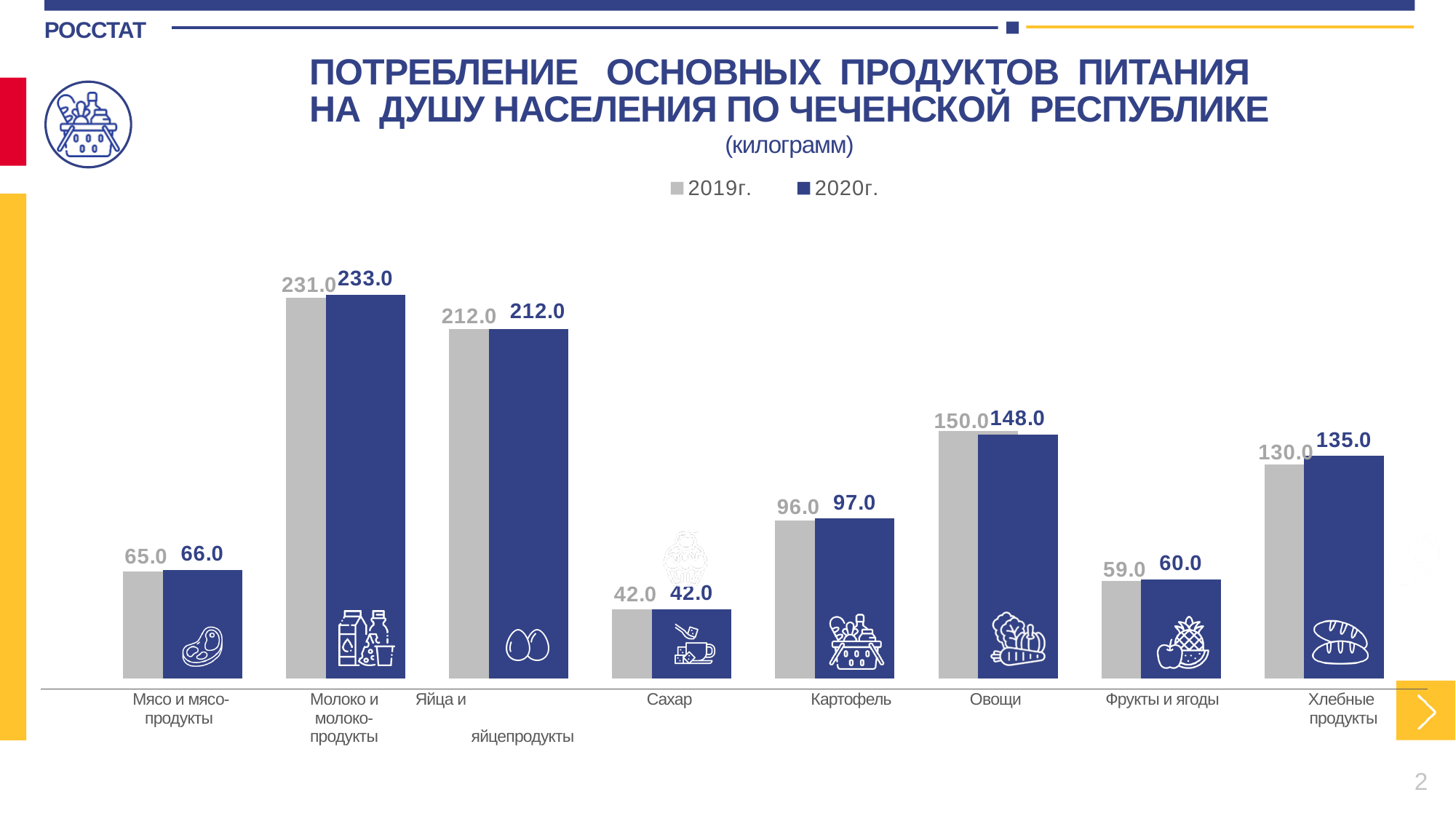
What is the 2020г. value for Картофель? 97.0 How many series does the legend list? 2 What is the difference between the 2019г. and 2020г. values for Овощи? 2.0 What unit of measurement is given under the chart title? килограмм How many product categories are shown on the chart? 8 Which category has the lowest 2019г. value? Сахар Which is larger for Фрукты и ягоды: the 2019г. value or the 2020г. value? 2020г. What is the 2020г. value for Хлебные продукты? 135.0 What is the difference between the 2020г. and 2019г. values for Хлебные продукты? 5.0 What is the 2019г. value for Овощи? 150.0 Which category has the highest 2020г. value? Молоко и молокопродукты What kind of chart is shown on the slide? Bar chart